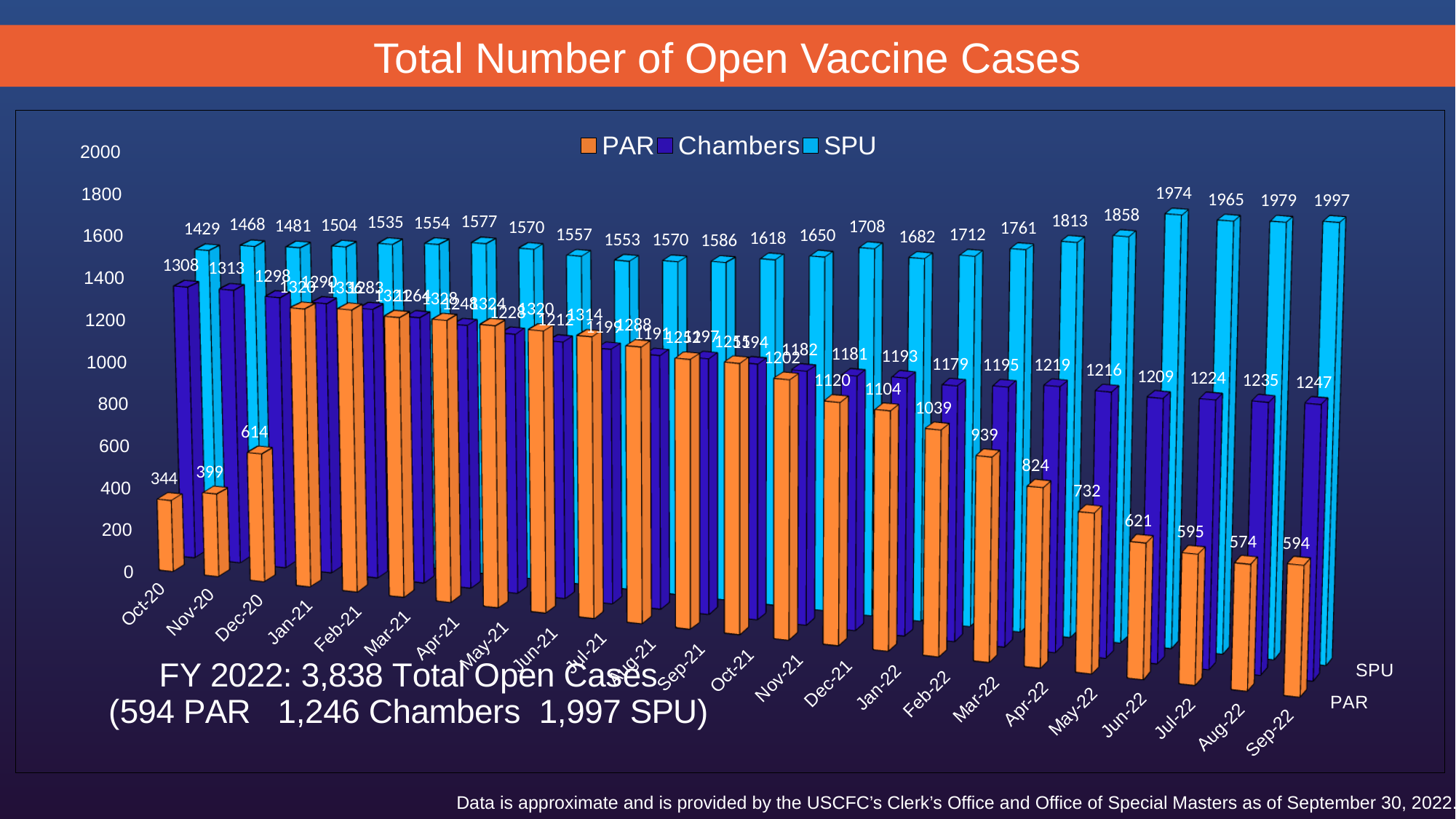
What is the Chambers value for Apr-22? 1219 What kind of chart is shown on the slide? Bar chart How many months are shown on the x axis? 24 In which month is the PAR value lowest? Oct-20 What is the difference between the PAR value for Dec-20 and the PAR value for Nov-20? 215 For Apr-22, which is larger: the PAR value or the Chambers value? Chambers What is the SPU value for Sep-22? 1997 How many series does the legend list? 3 What is the difference between the SPU value for Sep-22 and the SPU value for Oct-20? 568 Does the SPU value generally rise or fall from Oct-20 to Sep-22? Rise What is the PAR value for Oct-20? 344 In which month is the SPU value highest? Sep-22